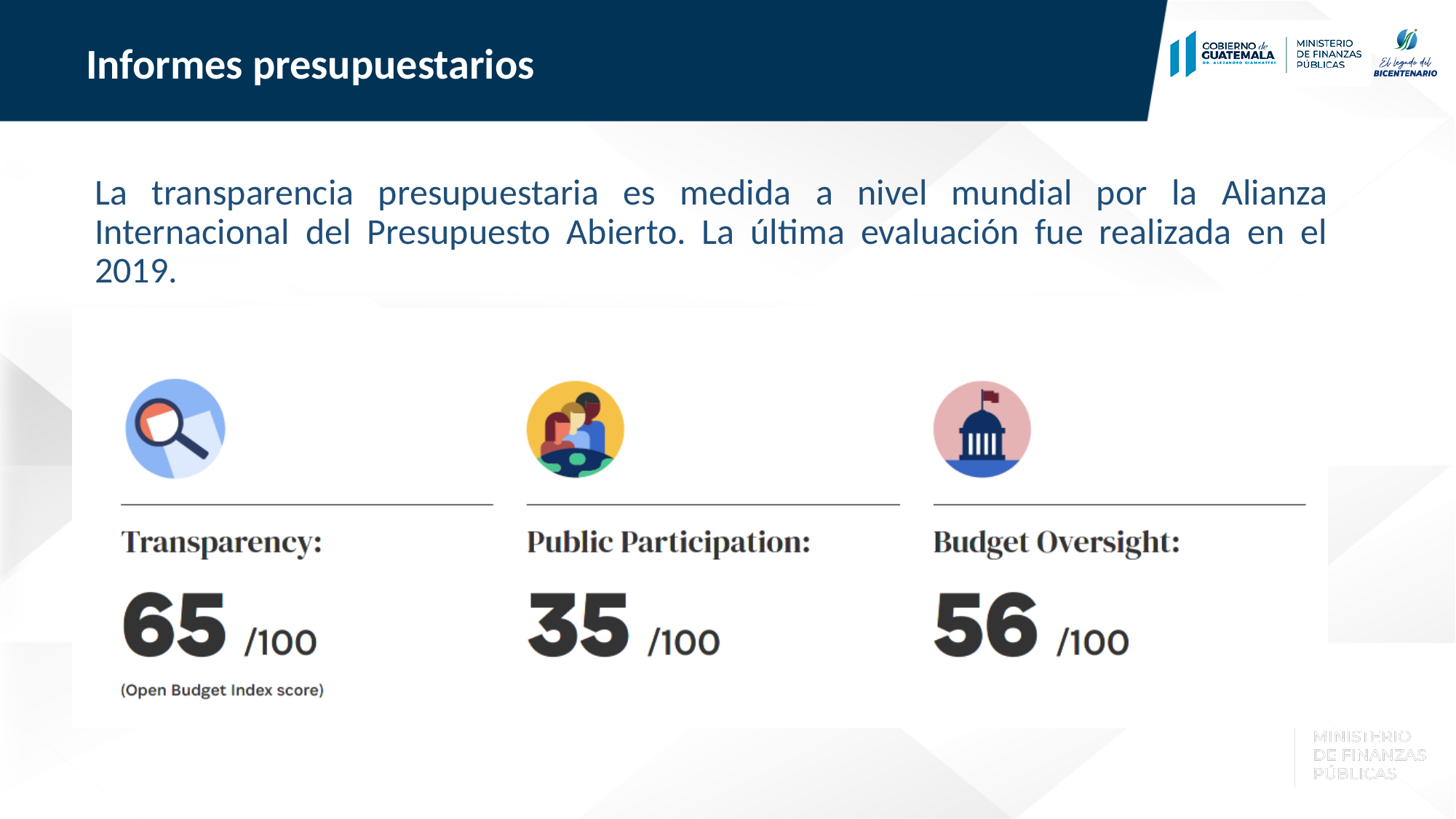
What is the Budget Oversight score shown on the slide? 56/100 What is the Public Participation score shown on the slide? 35/100 Which score is labelled as the Open Budget Index score? Transparency What is the difference between the Transparency score and the Public Participation score? 30 What is the Transparency score shown on the slide? 65/100 Out of what maximum are the three scores expressed? 100 Which is larger, the Budget Oversight score or the Public Participation score? Budget Oversight Which of the three categories has the highest score? Transparency What is the difference between the Transparency score and the Budget Oversight score? 9 How many score categories are shown on the slide? 3 Which of the three categories has the lowest score? Public Participation What is the difference between the Budget Oversight score and the Public Participation score? 21